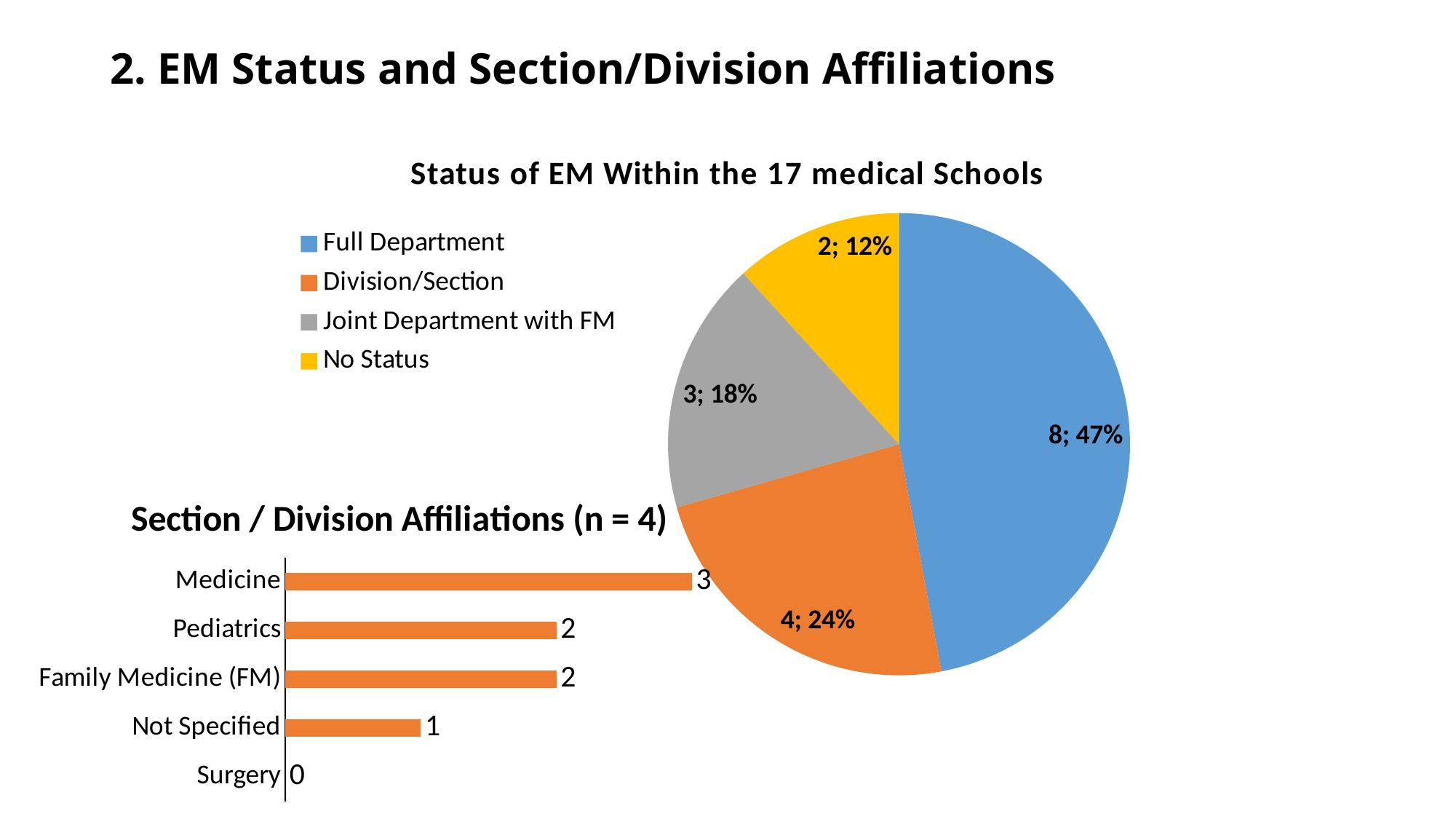
In the 'Status of EM Within the 17 medical Schools' chart, what kind of chart is shown? pie chart In the 'Status of EM Within the 17 medical Schools' chart, which category has the smallest slice? No Status In the 'Section / Division Affiliations (n = 4)' chart, which category has the lowest value? Surgery In the 'Status of EM Within the 17 medical Schools' chart, what colour is the Joint Department with FM slice? grey In the 'Status of EM Within the 17 medical Schools' chart, what is the difference in count between Full Department and Joint Department with FM? 5 In the 'Status of EM Within the 17 medical Schools' chart, how many schools have EM as a Full Department? 8 In the 'Status of EM Within the 17 medical Schools' chart, what share of the pie is Division/Section? 24% In the 'Status of EM Within the 17 medical Schools' chart, how many categories does the legend list? 4 In the 'Section / Division Affiliations (n = 4)' chart, how many categories are shown? 5 In the 'Section / Division Affiliations (n = 4)' chart, what is the value for Medicine? 3 In the 'Status of EM Within the 17 medical Schools' chart, which category has the largest slice? Full Department In the 'Section / Division Affiliations (n = 4)' chart, what kind of chart is shown? bar chart